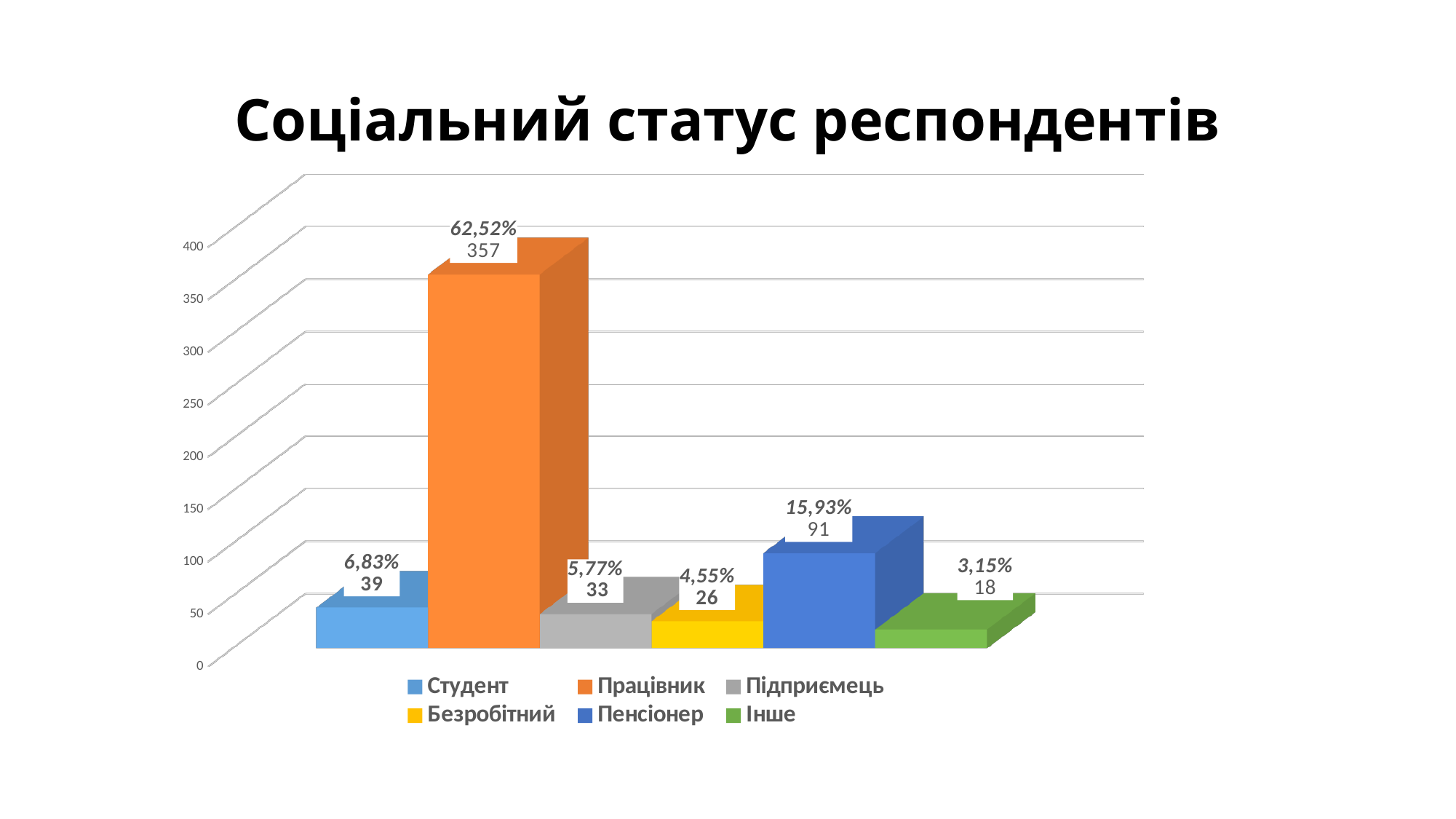
What is the title of the chart? Соціальний статус респондентів What type of chart is shown on the slide? Bar chart Which category has the highest number of respondents? Працівник What is the difference in respondents between Працівник and Пенсіонер? 266 What is the difference in respondents between Студент and Підприємець? 6 What is the number of respondents for Працівник? 357 What percentage is shown for Пенсіонер? 15,93% How many categories are shown in the chart? 6 What percentage is shown for Інше? 3,15% What is the number of respondents for Студент? 39 Which category has the lowest number of respondents? Інше Which has more respondents, Безробітний or Підприємець? Підприємець